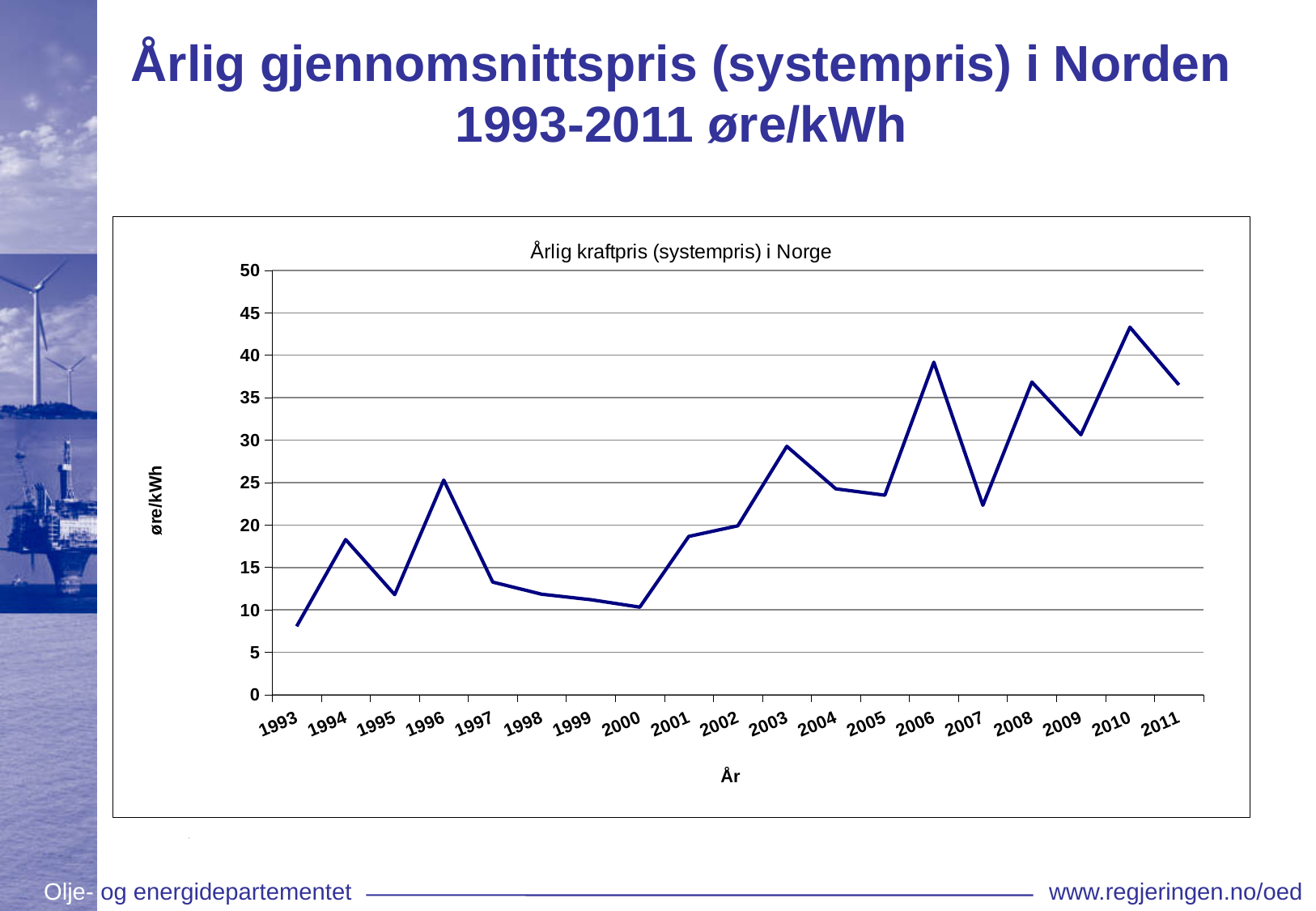
Is the value for 1996 greater or less than 20? greater Is the value for 2003 greater or less than 25? greater Is the value for 2006 greater or less than 35? greater What is the label on the y axis of the chart? øre/kWh Which year has the highest value in the chart? 2010 What kind of chart is shown on the slide? line chart Which year has the lowest value in the chart? 1993 Do the values generally rise or fall from 1996 to 2000? fall How many years are plotted along the x axis? 19 Which year has the larger value, 2006 or 2007? 2006 What is the title printed inside the chart area? Årlig kraftpris (systempris) i Norge